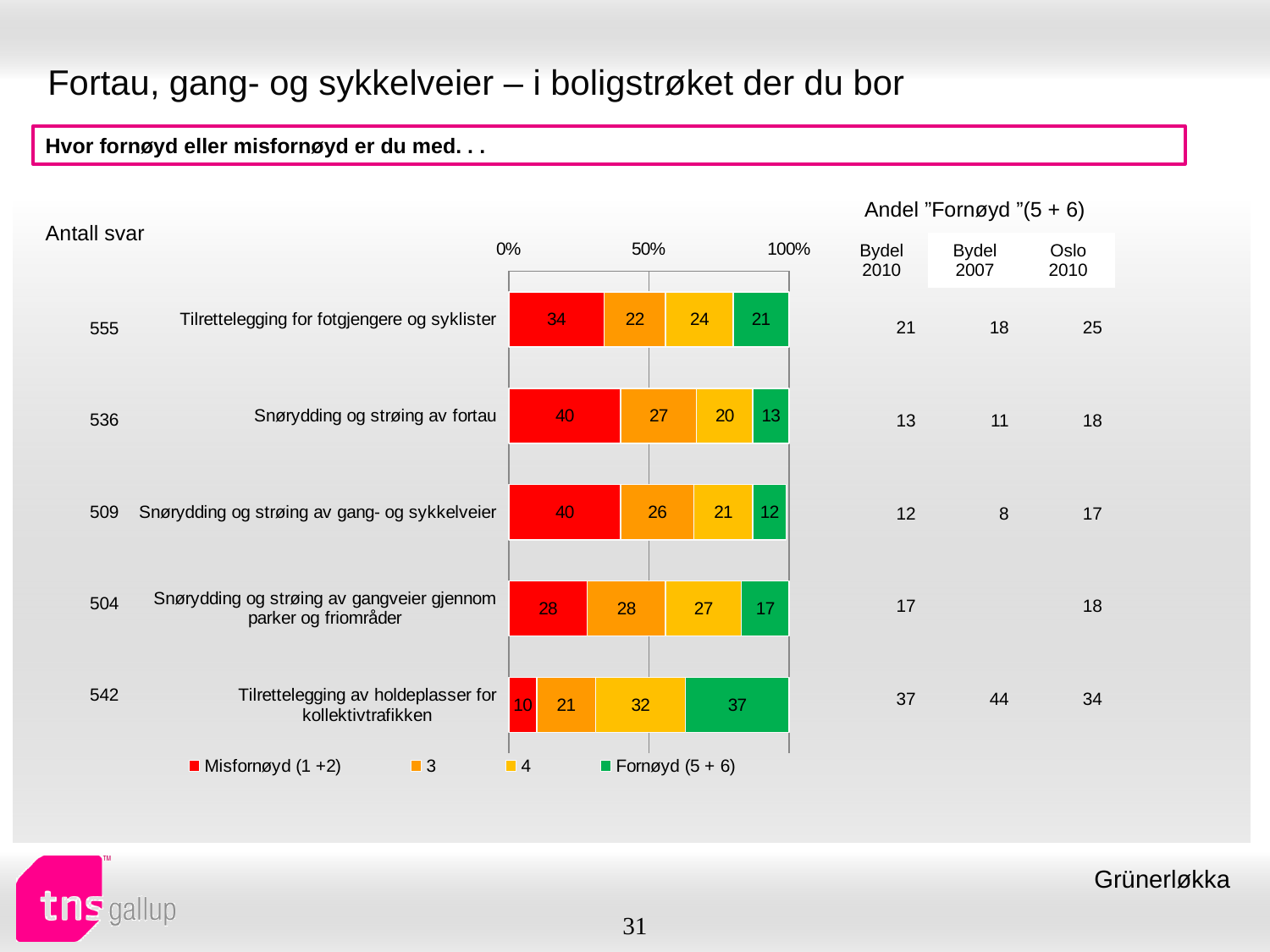
Which category has the highest Fornøyd (5 + 6) value? Tilrettelegging av holdeplasser for kollektivtrafikken What is the value of series 3 for Snørydding og strøing av gangveier gjennom parker og friområder? 28 Which category has the lowest Misfornøyd (1 +2) value? Tilrettelegging av holdeplasser for kollektivtrafikken How many series does the legend list? 4 What is the Misfornøyd (1 +2) value for Snørydding og strøing av fortau? 40 How many categories are shown in the bar chart? 5 Which is larger: the Misfornøyd (1 +2) value for Tilrettelegging for fotgjengere og syklister or for Snørydding og strøing av gangveier gjennom parker og friområder? Tilrettelegging for fotgjengere og syklister What is the Fornøyd (5 + 6) value for Tilrettelegging for fotgjengere og syklister? 21 What kind of chart is shown on the slide? Stacked bar chart Which category has the lowest Fornøyd (5 + 6) value? Snørydding og strøing av gang- og sykkelveier What is the difference between the Fornøyd (5 + 6) values for Tilrettelegging av holdeplasser for kollektivtrafikken and Snørydding og strøing av fortau? 24 What is the value of series 4 for Tilrettelegging av holdeplasser for kollektivtrafikken? 32